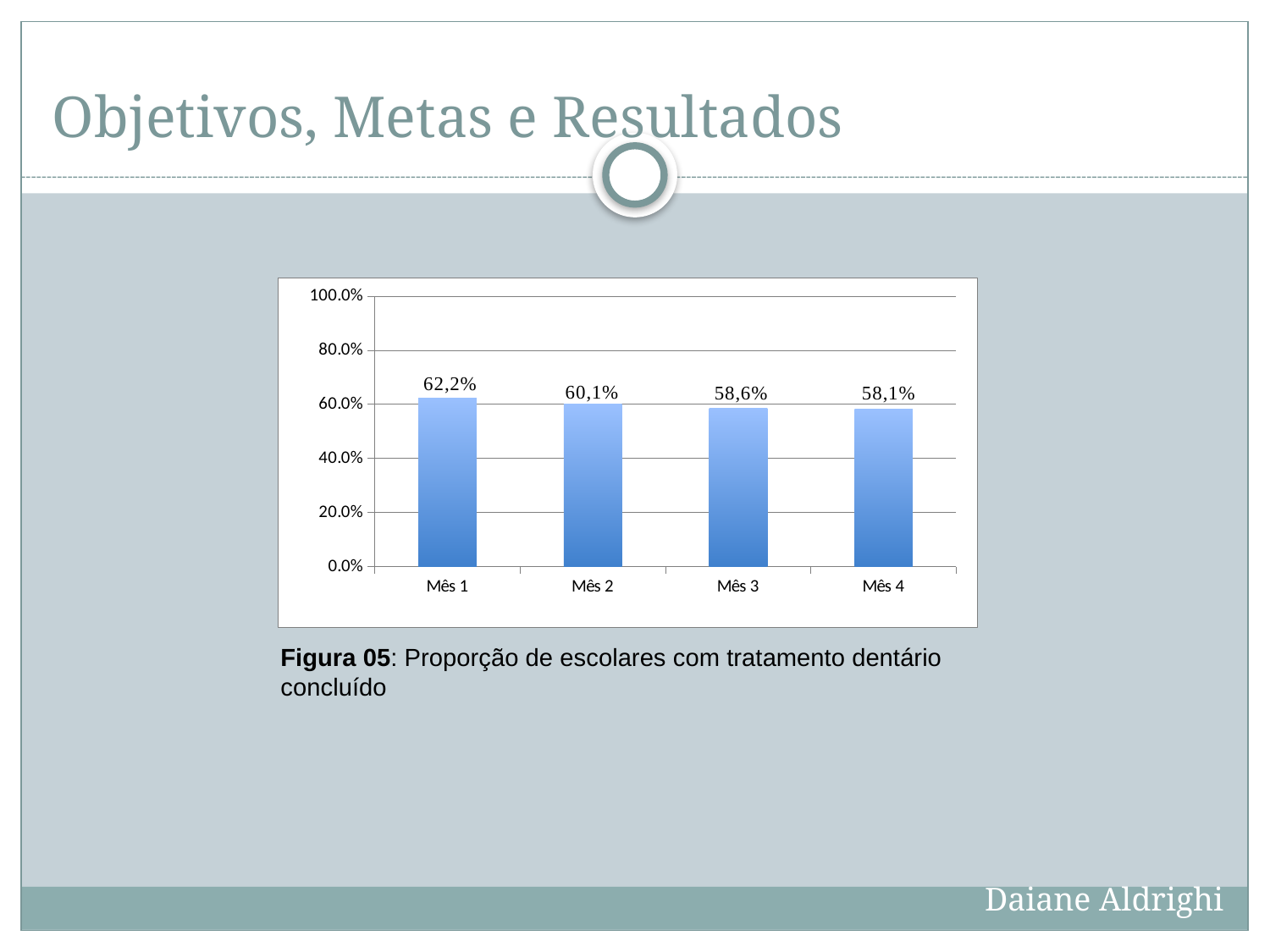
Which month has the highest proportion? Mês 1 How many months are shown on the x axis? 4 Which is larger, the value for Mês 2 or the value for Mês 3? Mês 2 What kind of chart is shown? bar chart What is the value for Mês 3? 58,6% What is the value for Mês 4? 58,1% What is the difference between the values for Mês 1 and Mês 4? 4,1 percentage points What is the difference between the values for Mês 1 and Mês 2? 2,1 percentage points What is the value for Mês 1? 62,2% Which month has the lowest proportion? Mês 4 Do the values rise or fall from Mês 1 to Mês 4? fall Is the value for Mês 4 greater or less than 80.0%? less